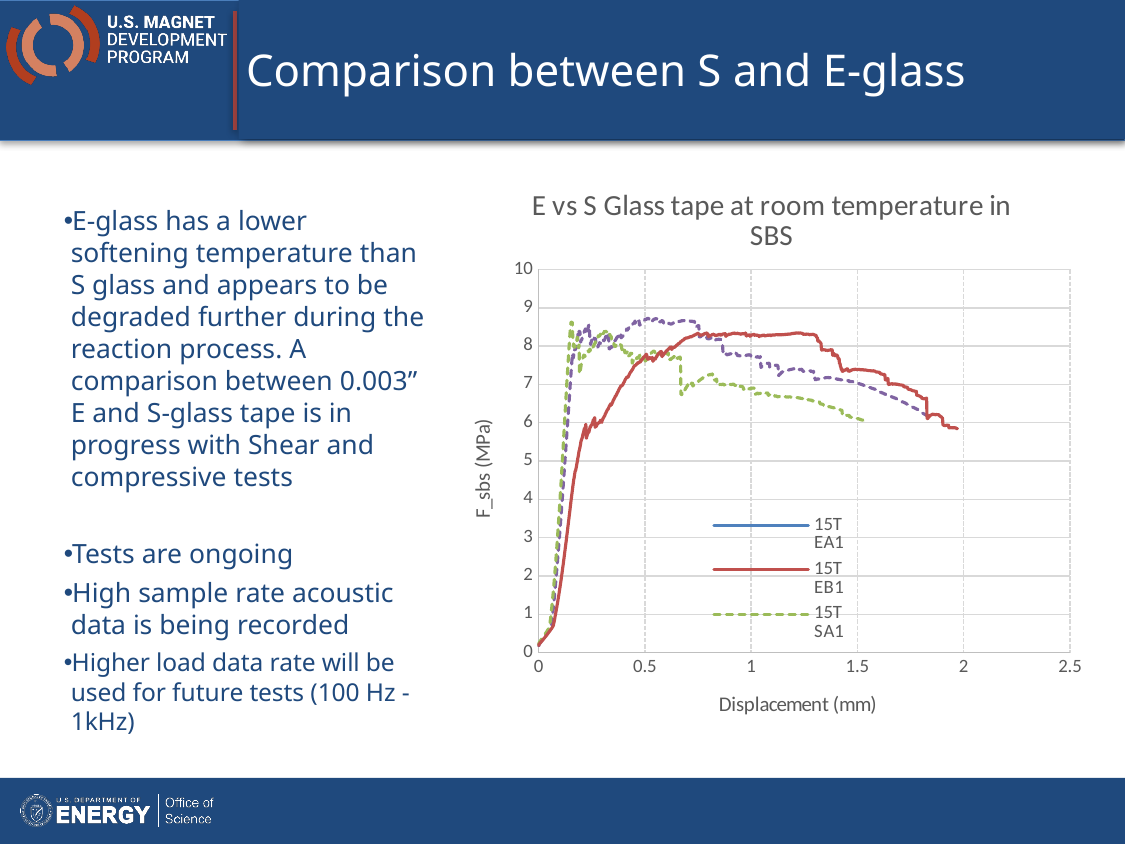
Is the peak value of the 15T SA1 series greater or less than 8? greater Which series extends furthest along the displacement axis? 15T EB1 What kind of chart is shown on the slide? line chart What is the label of the x axis of the chart? Displacement (mm) What is the highest value shown on the x axis of the chart? 2.5 Does the 15T EB1 series rise or fall between displacements of 1.5 mm and 2 mm? fall Is the value of the 15T EB1 series at a displacement of 1.5 mm greater or less than 7? greater What is the title of the chart? E vs S Glass tape at room temperature in SBS What is the highest value shown on the y axis of the chart? 10 Is the peak value of the 15T EB1 series greater or less than 8? greater Does the 15T EB1 series rise or fall between displacements of 0 mm and 0.5 mm? rise How many series does the chart legend list? 3